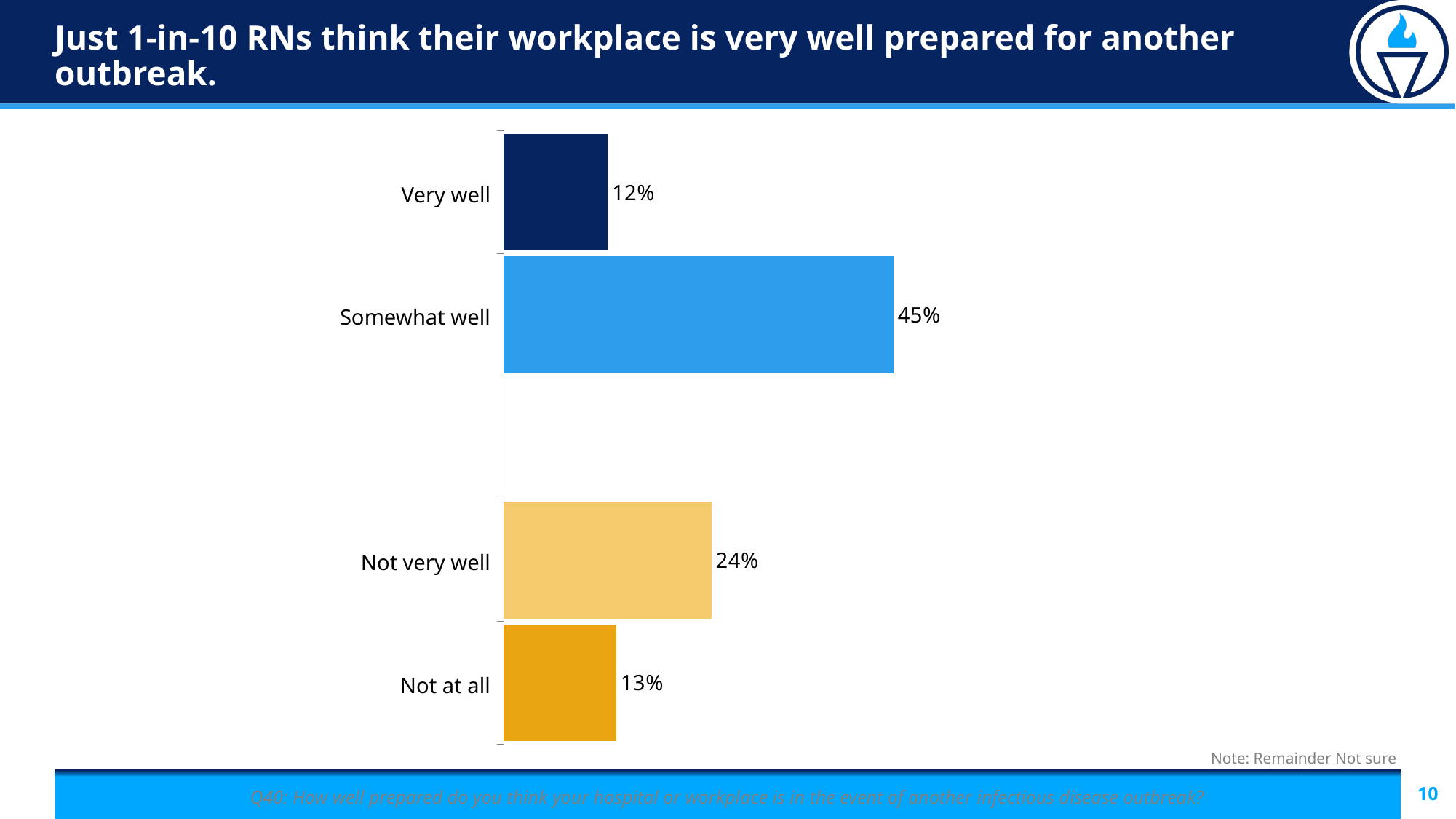
What percentage of RNs said their workplace is not very well prepared? 24% What kind of chart is shown on the slide? Bar chart What percentage of RNs said their workplace is very well prepared? 12% What is the combined percentage of RNs who said 'Very well' or 'Somewhat well'? 57% What is the difference in percentage points between 'Somewhat well' and 'Not very well'? 21 What percentage of RNs said their workplace is somewhat well prepared? 45% Which is larger, the value for 'Not very well' or the value for 'Not at all'? Not very well What percentage of RNs said their workplace is not at all prepared? 13% How many response categories are shown in the chart? 4 What is the difference in percentage points between 'Not at all' and 'Very well'? 1 Which response category has the highest percentage? Somewhat well Which response category has the lowest percentage? Very well